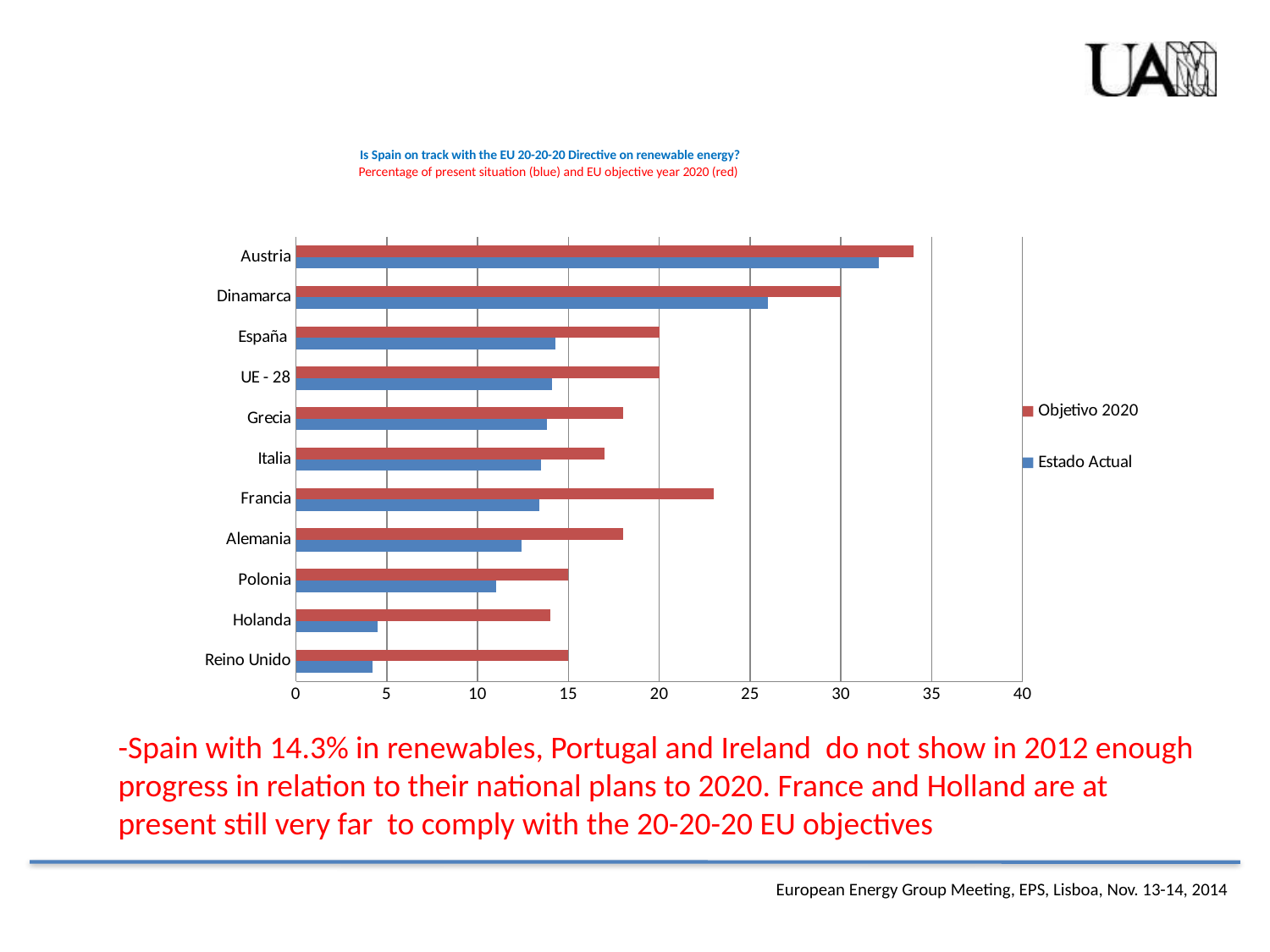
What is the Objetivo 2020 value for España? 20 How many series does the chart legend list? 2 Is the Objetivo 2020 value for Francia greater or less than 20? greater Which colour represents the Objetivo 2020 series in the legend? red What is the Objetivo 2020 value for Dinamarca? 30 Which category has the highest Objetivo 2020 value? Austria What kind of chart is shown on the slide? bar chart Which has the larger Objetivo 2020 value, Francia or Alemania? Francia Is the Estado Actual value for Holanda greater or less than 5? less Which category has the highest Estado Actual value? Austria Is the Estado Actual value for Austria greater or less than 30? greater How many countries/regions are plotted on the chart? 11